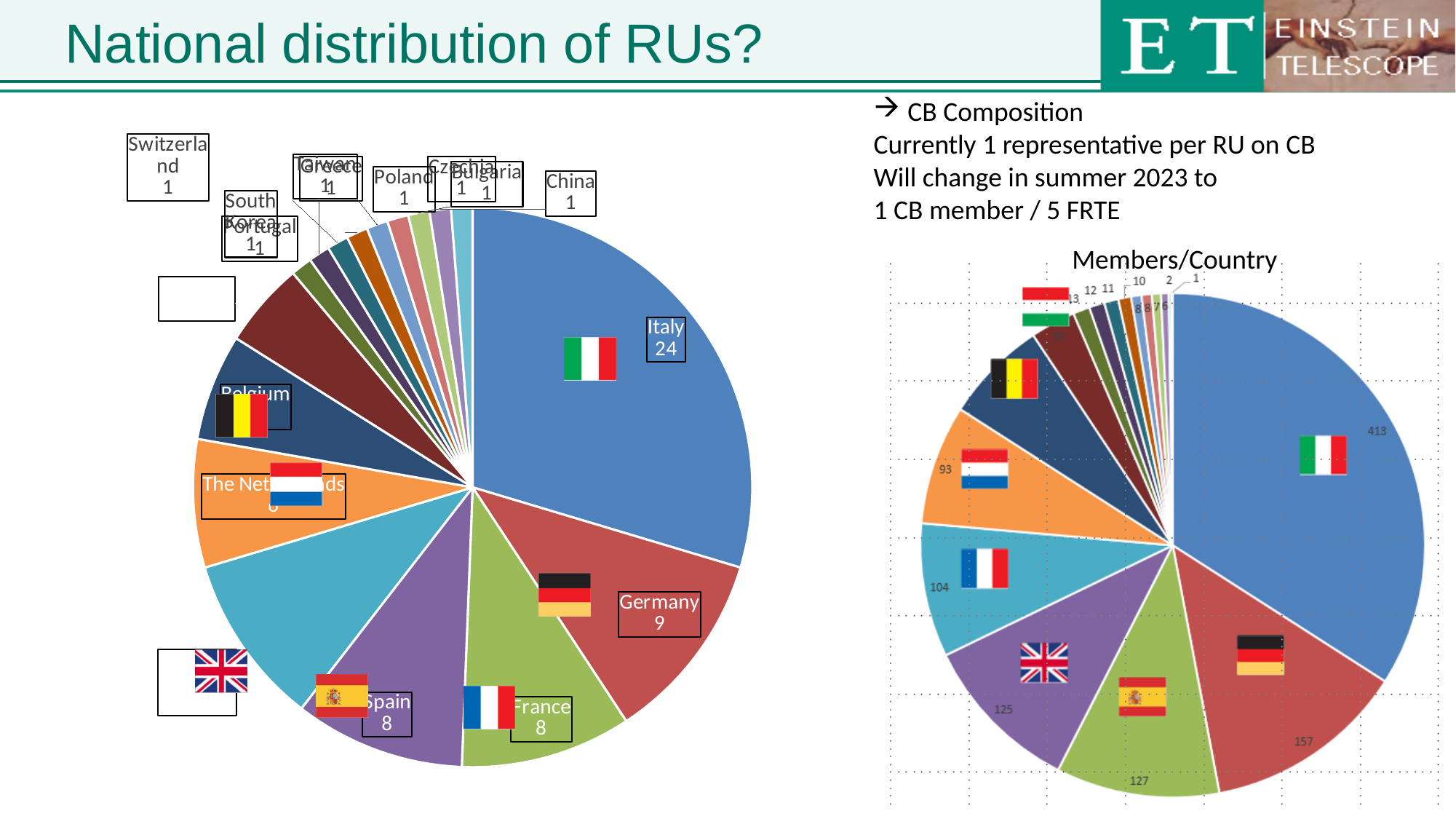
What kind of chart is the left chart on the slide? Pie chart In the Members/Country chart, which is larger, the slice with the French flag or the slice with the Dutch flag? The slice with the French flag (104) In the left pie chart, what is the value shown for France? 8 In the left pie chart, how many RUs does Italy have? 24 In the left pie chart, which is larger, the value for Germany or the value for France? Germany In the Members/Country chart, what is the difference between the slice with the German flag (157) and the slice with the Spanish flag (127)? 30 In the left pie chart, which country has the largest slice? Italy In the Members/Country chart, what is the value of the slice marked with the German flag? 157 In the Members/Country chart, what is the value of the largest slice (the one with the Italian flag)? 413 In the left pie chart, what is the difference between the values for Italy and Germany? 15 What is the title of the right chart? Members/Country In the left pie chart, what is the value shown for Germany? 9